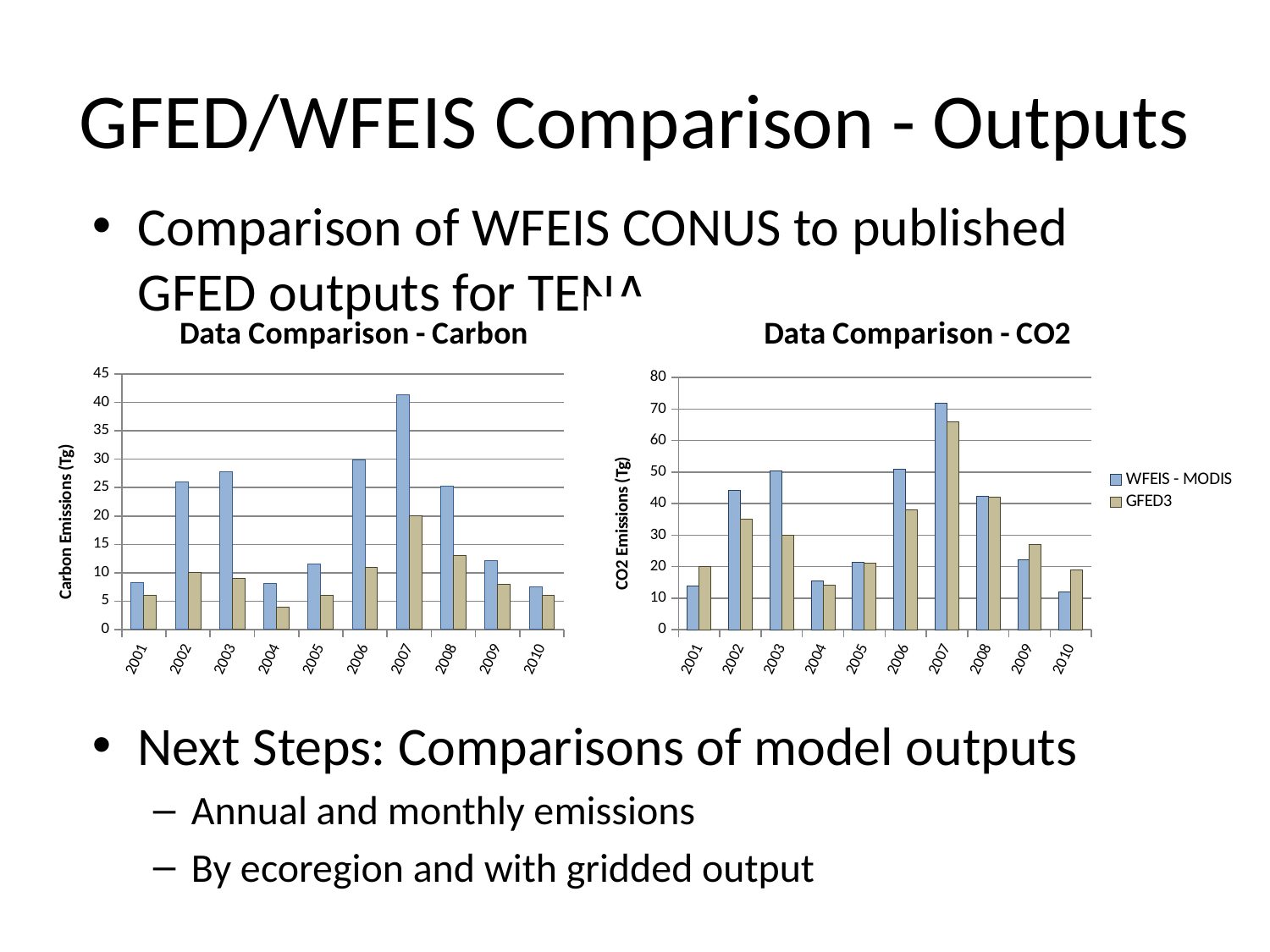
In the "Data Comparison - Carbon" chart, is the WFEIS - MODIS value for 2007 greater or less than 40? greater In the "Data Comparison - CO2" chart, is the WFEIS - MODIS value for 2007 greater or less than 70? greater In the "Data Comparison - Carbon" chart, which year has the highest WFEIS - MODIS carbon emissions? 2007 What is the y-axis label of the "Data Comparison - CO2" chart? CO2 Emissions (Tg) In the "Data Comparison - CO2" chart, which series has the larger value for 2001, WFEIS - MODIS or GFED3? GFED3 In the "Data Comparison - CO2" chart, is the GFED3 value for 2003 greater or less than 40? less How many series does the legend list for the "Data Comparison - CO2" chart? 2 In the "Data Comparison - CO2" chart, which year has the highest GFED3 CO2 emissions? 2007 In the "Data Comparison - Carbon" chart, which year has the lowest GFED3 carbon emissions? 2004 In the "Data Comparison - Carbon" chart, which series has the larger value for 2006, WFEIS - MODIS or GFED3? WFEIS - MODIS How many years are shown on the x axis of the "Data Comparison - CO2" chart? 10 What kind of chart is "Data Comparison - Carbon"? bar chart